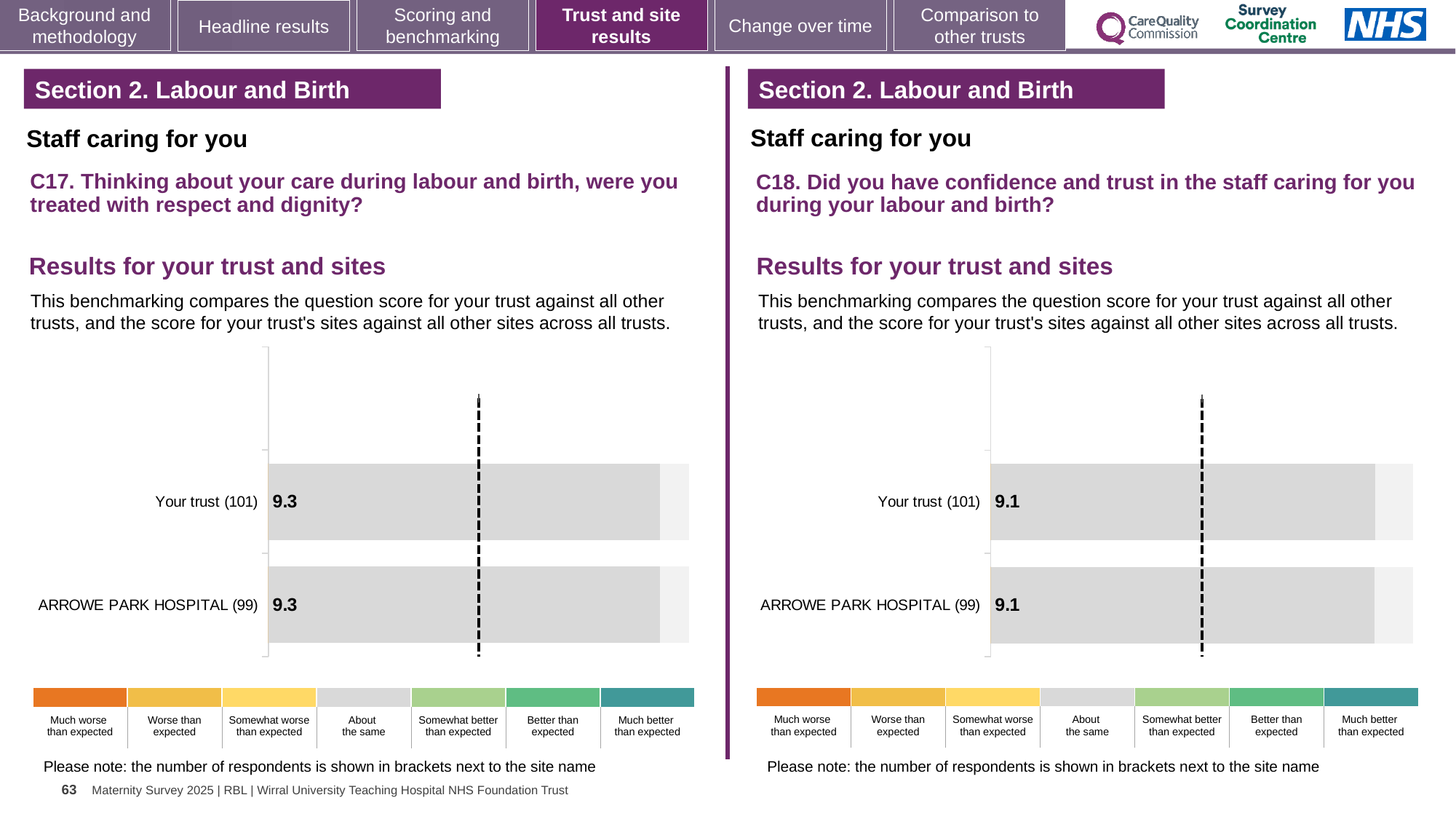
In the C17 chart on the left, how many respondents are shown in brackets next to Your trust? 101 In the C17 chart on the left, which category of the colour key does the grey colour of the bars correspond to? About the same In the C17 chart on the left, what is the score for Your trust? 9.3 In the C17 chart on the left, what is the score for ARROWE PARK HOSPITAL? 9.3 How many categories does the colour key below the C18 chart on the right list? 7 In the C18 chart on the right, how many respondents are shown in brackets next to ARROWE PARK HOSPITAL? 99 In the C18 chart on the right, how many bars are plotted? 2 In the C18 chart on the right, what is the score for Your trust? 9.1 In the C18 chart on the right, what is the score for ARROWE PARK HOSPITAL? 9.1 In the C17 chart on the left, what is the difference between the score for Your trust and the score for ARROWE PARK HOSPITAL? 0 What kind of chart is the C17 chart on the left? Bar chart